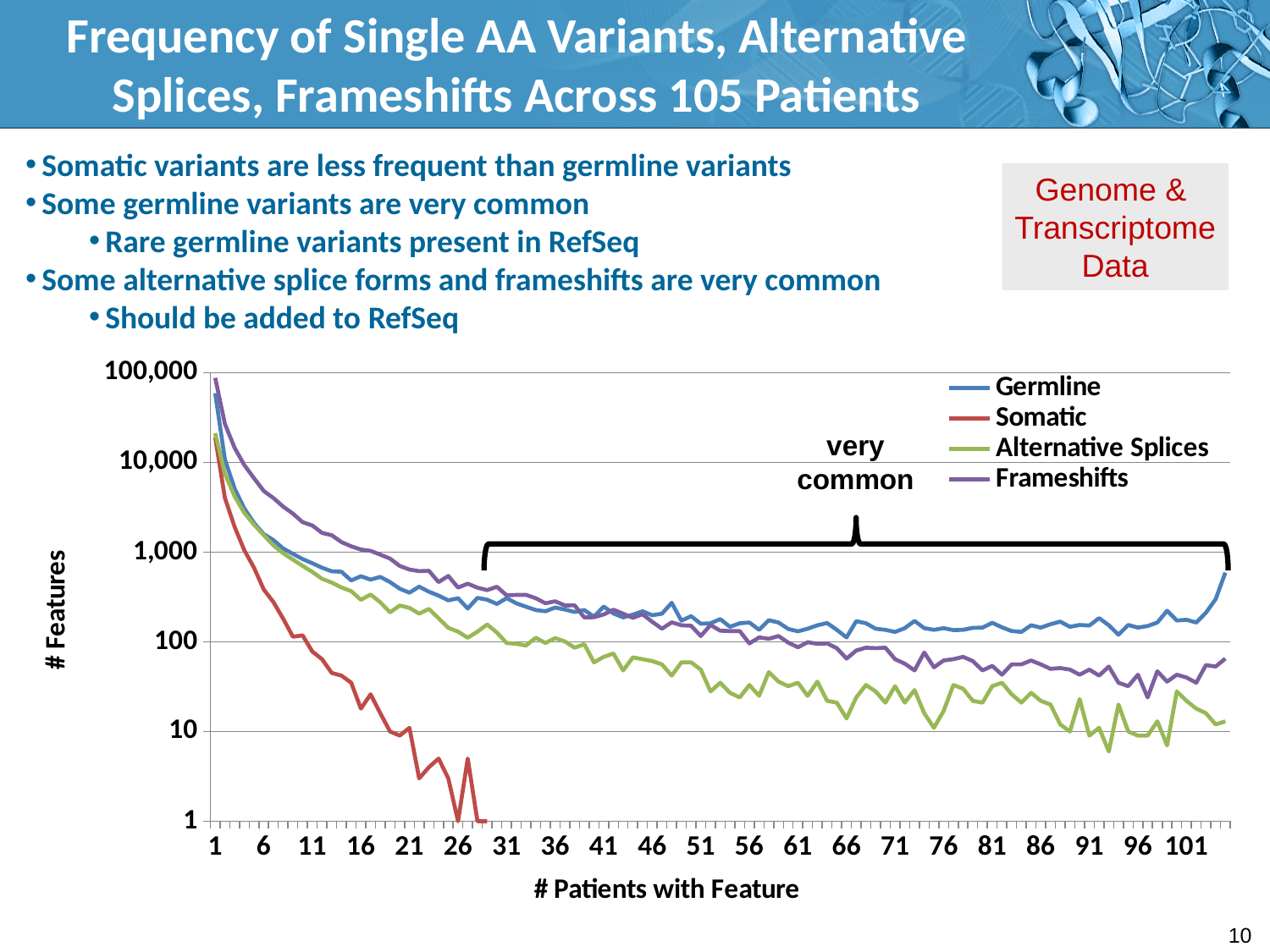
What are the four series listed in the chart legend? Germline, Somatic, Alternative Splices, Frameshifts How many series does the chart legend list? 4 Is the Germline value at 6 patients greater or less than 1,000? greater Is the Frameshifts value at 6 patients greater or less than 1,000? greater At 6 patients, which series has the larger value, Frameshifts or Somatic? Frameshifts What kind of chart is shown on the slide? line chart Is the Germline value at 51 patients greater or less than 100? greater At 51 patients, which series has the larger value, Germline or Alternative Splices? Germline What is the title of the chart's x axis? # Patients with Feature Does the Somatic series rise or fall as the number of patients with the feature increases? fall